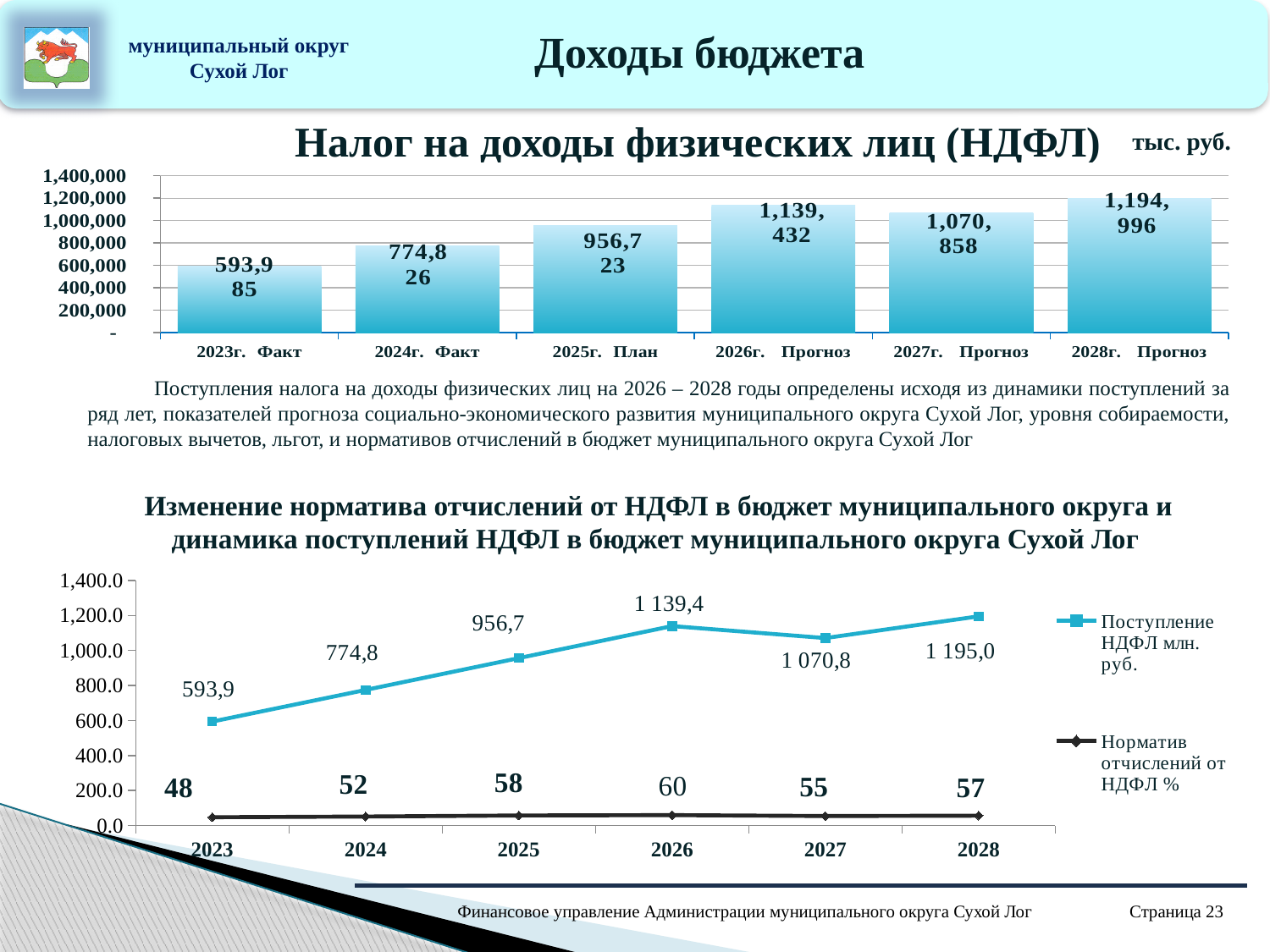
In the top chart "Налог на доходы физических лиц (НДФЛ)", which category has the lowest value? 2023г. Факт In the top chart "Налог на доходы физических лиц (НДФЛ)", what is the value for 2025г. План? 956,723 In the top chart "Налог на доходы физических лиц (НДФЛ)", which is larger: the value for 2026г. Прогноз or 2027г. Прогноз? 2026г. Прогноз In the bottom line chart, what is the value of "Норматив отчислений от НДФЛ %" for 2025? 58 In the top chart "Налог на доходы физических лиц (НДФЛ)", which category has the highest value? 2028г. Прогноз In the bottom line chart, what is the value of "Поступление НДФЛ млн. руб." for 2026? 1 139,4 In the bottom line chart, what is the difference between the "Норматив отчислений от НДФЛ %" values for 2024 and 2023? 4 In the bottom line chart, in which year is "Норматив отчислений от НДФЛ %" highest? 2026 What type of chart is the top chart titled "Налог на доходы физических лиц (НДФЛ)"? bar chart In the bottom line chart, how many series does the legend list? 2 In the top chart "Налог на доходы физических лиц (НДФЛ)", is the value for 2026г. Прогноз greater or less than 1,000,000? greater In the top chart "Налог на доходы физических лиц (НДФЛ)", how many bars are plotted? 6